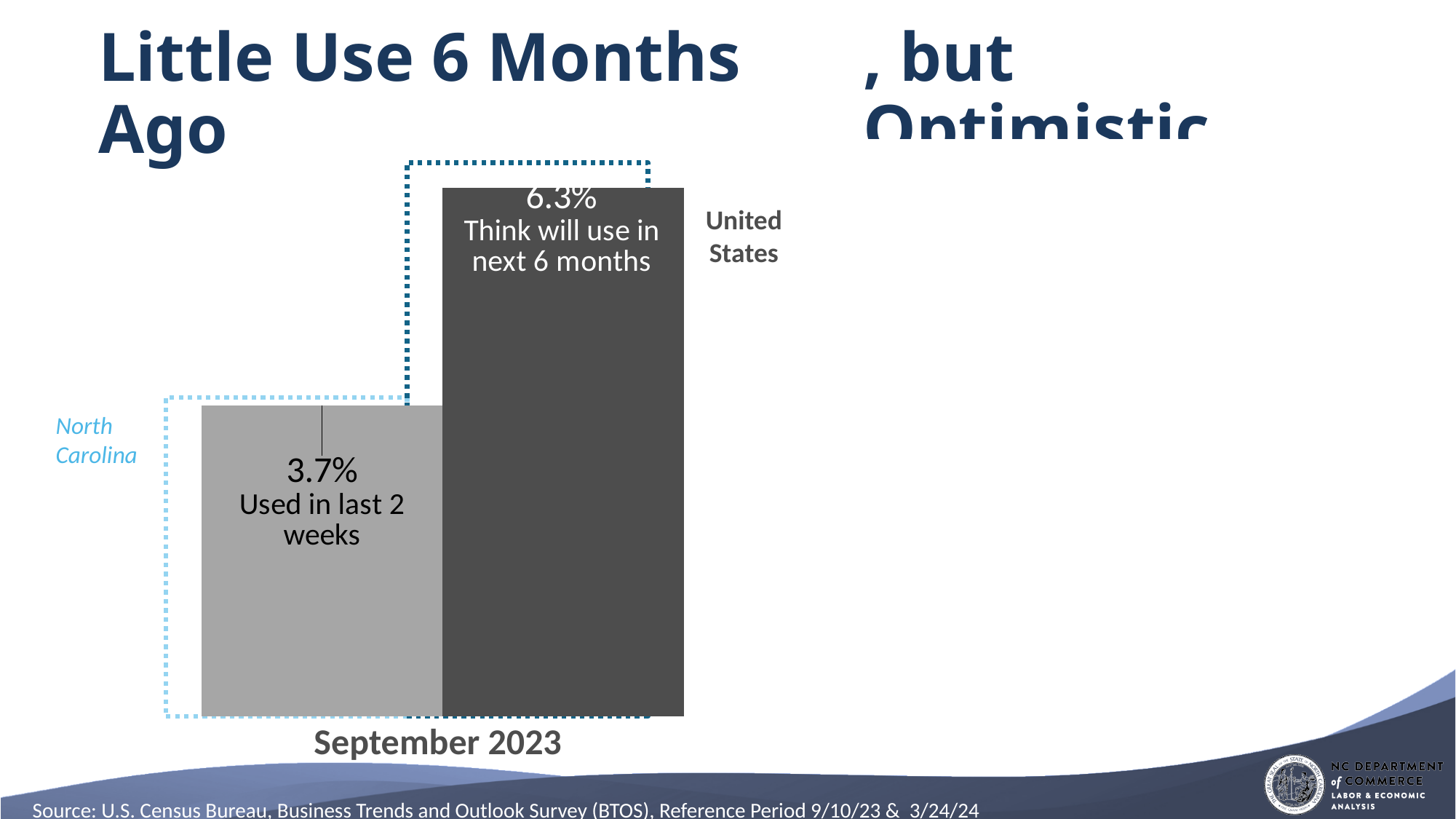
What percentage of businesses used AI in the last 2 weeks, according to the chart? 3.7% What time period is labeled beneath the bars? September 2023 How many bars are plotted in the chart? 2 What percentage of businesses think they will use AI in the next 6 months, according to the chart? 6.3% Is the value for 'Used in last 2 weeks' larger or smaller than the value for 'Think will use in next 6 months'? smaller What is the difference in percentage points between 'Think will use in next 6 months' and 'Used in last 2 weeks'? 2.6 percentage points Which bar is taller: 'Used in last 2 weeks' or 'Think will use in next 6 months'? Think will use in next 6 months What colour is the 'Think will use in next 6 months' bar? dark gray What kind of chart is shown on the slide? bar chart Which bar has the lowest value in the chart? Used in last 2 weeks